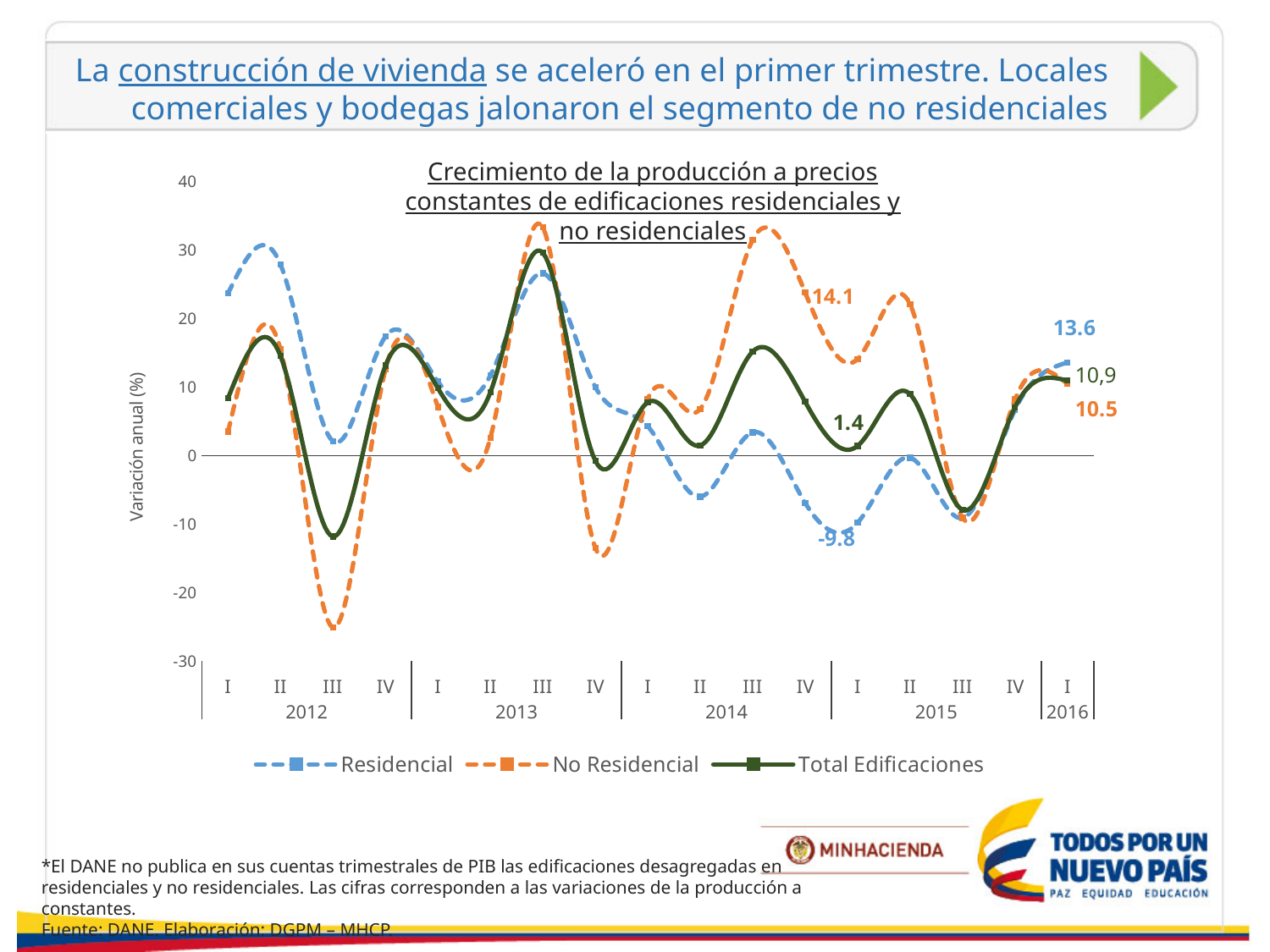
Is the value of the No Residencial series in the third quarter of 2012 greater or less than -20? less What is the value of the Total Edificaciones series in the first quarter of 2015? 1.4 In the first quarter of 2016, which series has the higher value: Residencial or No Residencial? Residencial What is the value of the Residencial series in the first quarter of 2015? -9.8 How many series does the legend list? 3 What is the difference between the Residencial value (13.6) and the No Residencial value (10.5) in the first quarter of 2016? 3.1 What is the value of the Total Edificaciones series in the first quarter of 2016? 10,9 What is the value of the No Residencial series in the first quarter of 2016? 10.5 What kind of chart is shown on the slide? line chart What is the value of the Residencial series in the first quarter of 2016? 13.6 How many quarters are plotted along the x axis? 17